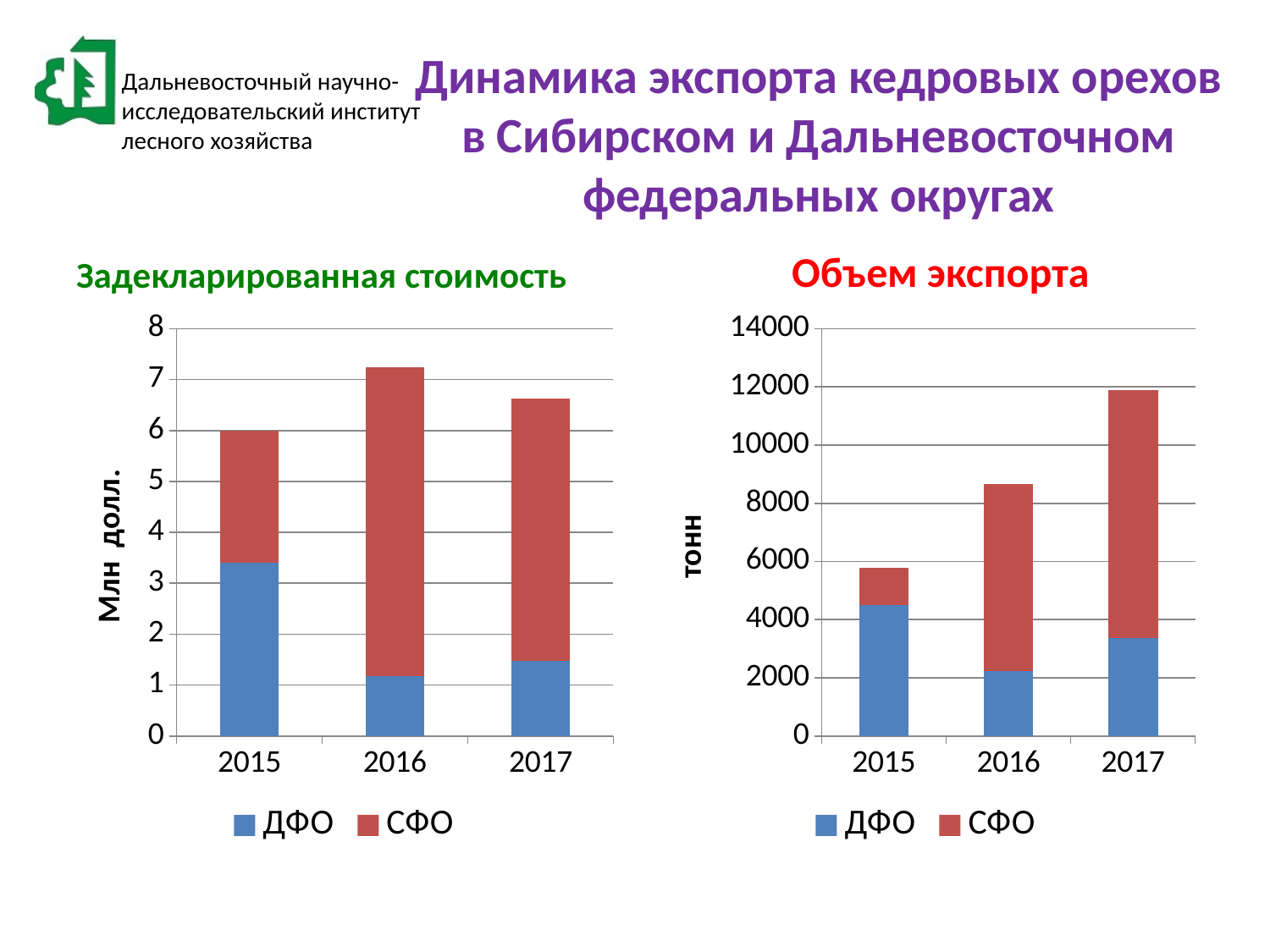
In the "Объем экспорта" chart, do the total stacked bars rise or fall from 2015 to 2017? rise In the "Объем экспорта" chart, is the total stacked bar for 2017 greater or less than 10000? greater How many years are shown on the x axis of the "Задекларированная стоимость" chart? 3 What is the y-axis title of the "Объем экспорта" chart? тонн In the "Объем экспорта" chart, is the ДФО value for 2016 greater or less than 4000? less What kind of chart is the "Задекларированная стоимость" chart on the left? stacked bar chart In the "Задекларированная стоимость" chart, which is larger for 2015: the ДФО segment or the СФО segment? ДФО In the "Объем экспорта" chart, which year has the shortest stacked bar? 2015 In the "Объем экспорта" chart, which year has the tallest stacked bar? 2017 How many series does the legend of the "Объем экспорта" chart list? 2 In the "Задекларированная стоимость" chart, which year has the tallest stacked bar? 2016 In the "Задекларированная стоимость" chart, is the ДФО value for 2015 greater or less than 3? greater